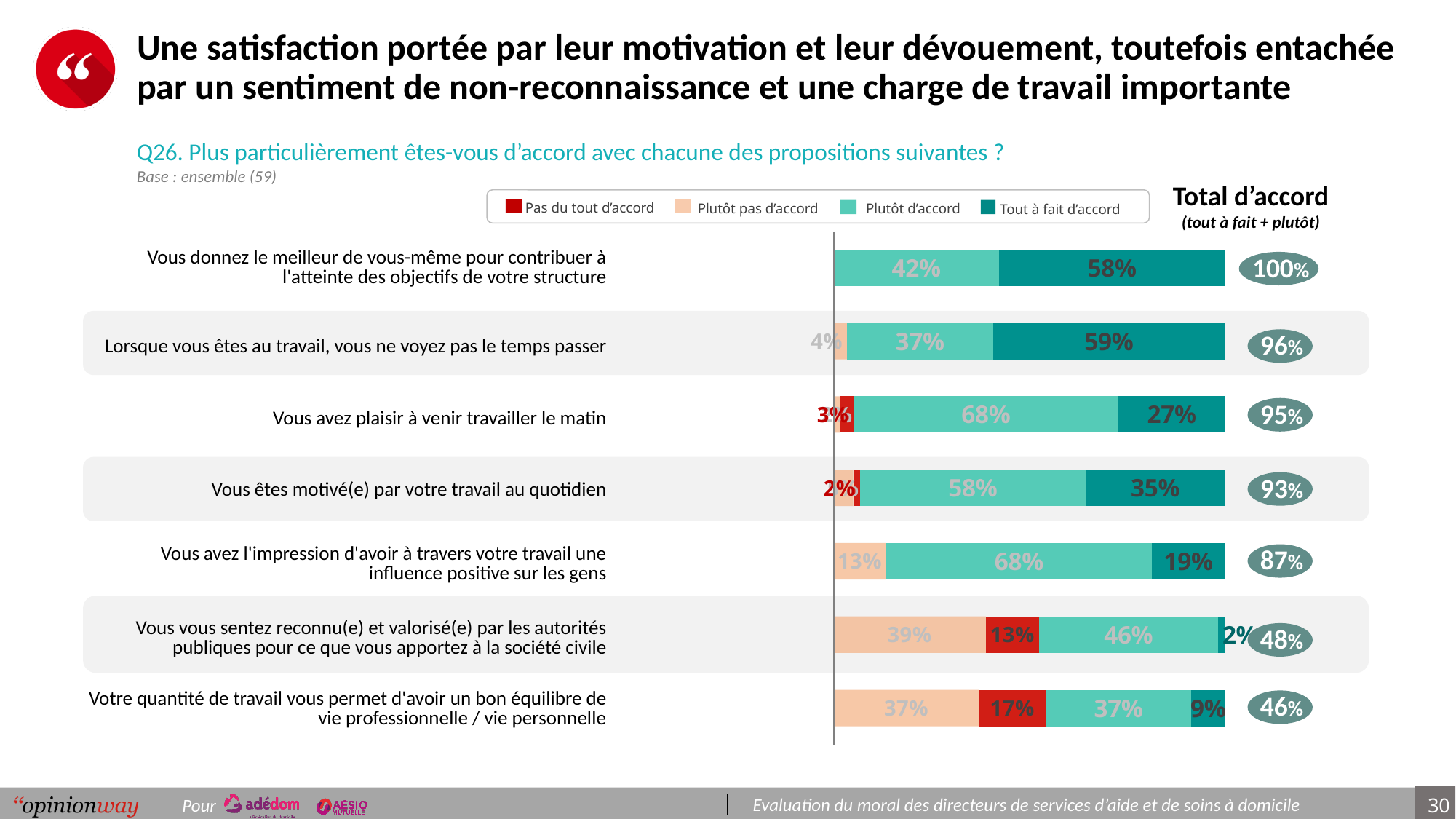
How many propositions (categories) are plotted in the chart? 7 Which is larger: the 'Tout à fait d'accord' value for 'Vous avez l'impression d'avoir à travers votre travail une influence positive sur les gens' or for 'Vous avez plaisir à venir travailler le matin'? Vous avez plaisir à venir travailler le matin What is the 'Pas du tout d'accord' value for 'Votre quantité de travail vous permet d'avoir un bon équilibre de vie professionnelle / vie personnelle'? 17% What is the difference between the 'Tout à fait d'accord' values for 'Lorsque vous êtes au travail, vous ne voyez pas le temps passer' and 'Vous êtes motivé(e) par votre travail au quotidien'? 24 percentage points Which proposition has the highest 'Total d'accord'? Vous donnez le meilleur de vous-même pour contribuer à l'atteinte des objectifs de votre structure How many series does the legend list? 4 What kind of chart is shown on the slide? Stacked bar chart What is the 'Plutôt d'accord' value for 'Vous avez plaisir à venir travailler le matin'? 68% What is the 'Plutôt pas d'accord' value for 'Vous vous sentez reconnu(e) et valorisé(e) par les autorités publiques pour ce que vous apportez à la société civile'? 39% Which proposition has the lowest 'Total d'accord'? Votre quantité de travail vous permet d'avoir un bon équilibre de vie professionnelle / vie personnelle What is the 'Total d'accord' shown for 'Vous êtes motivé(e) par votre travail au quotidien'? 93% What is the 'Tout à fait d'accord' value for 'Vous donnez le meilleur de vous-même pour contribuer à l'atteinte des objectifs de votre structure'? 58%